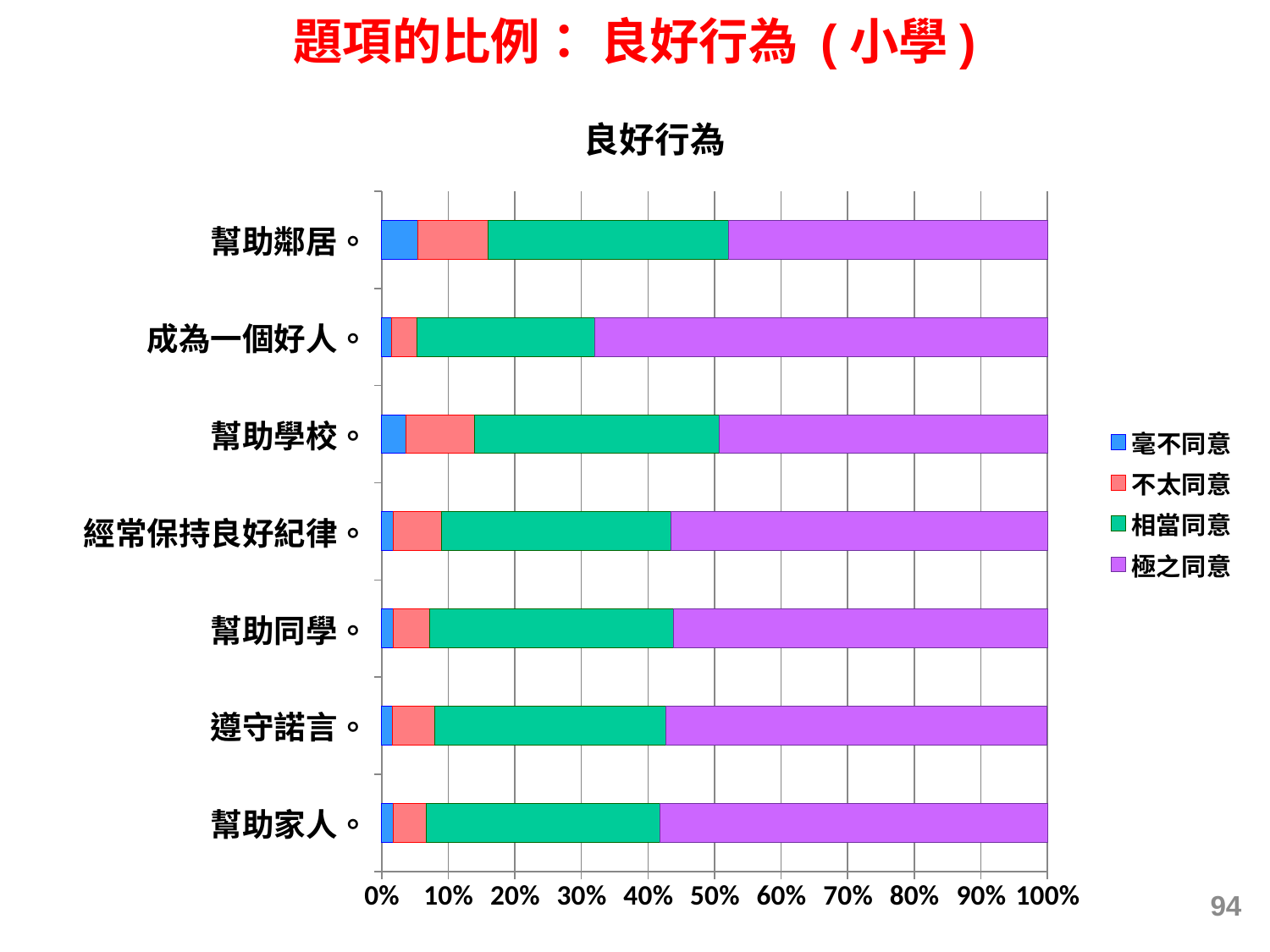
What kind of chart is shown on the slide? Stacked bar chart Which legend entry is shown in purple? 極之同意 How many categories (items) are plotted on the chart? 7 Is the 極之同意 share for 成為一個好人 greater or less than 60%? greater Is the 極之同意 share for 幫助鄰居 greater or less than 50%? less How many series does the legend list? 4 Is the 極之同意 share for 幫助家人 greater or less than 50%? greater Which has the larger 極之同意 share: 成為一個好人 or 幫助鄰居? 成為一個好人。 Which category has the largest 極之同意 segment? 成為一個好人。 Which category has the largest 毫不同意 segment? 幫助鄰居。 What is the title of the chart? 良好行為 Which has the larger 相當同意 share: 幫助學校 or 成為一個好人? 幫助學校。